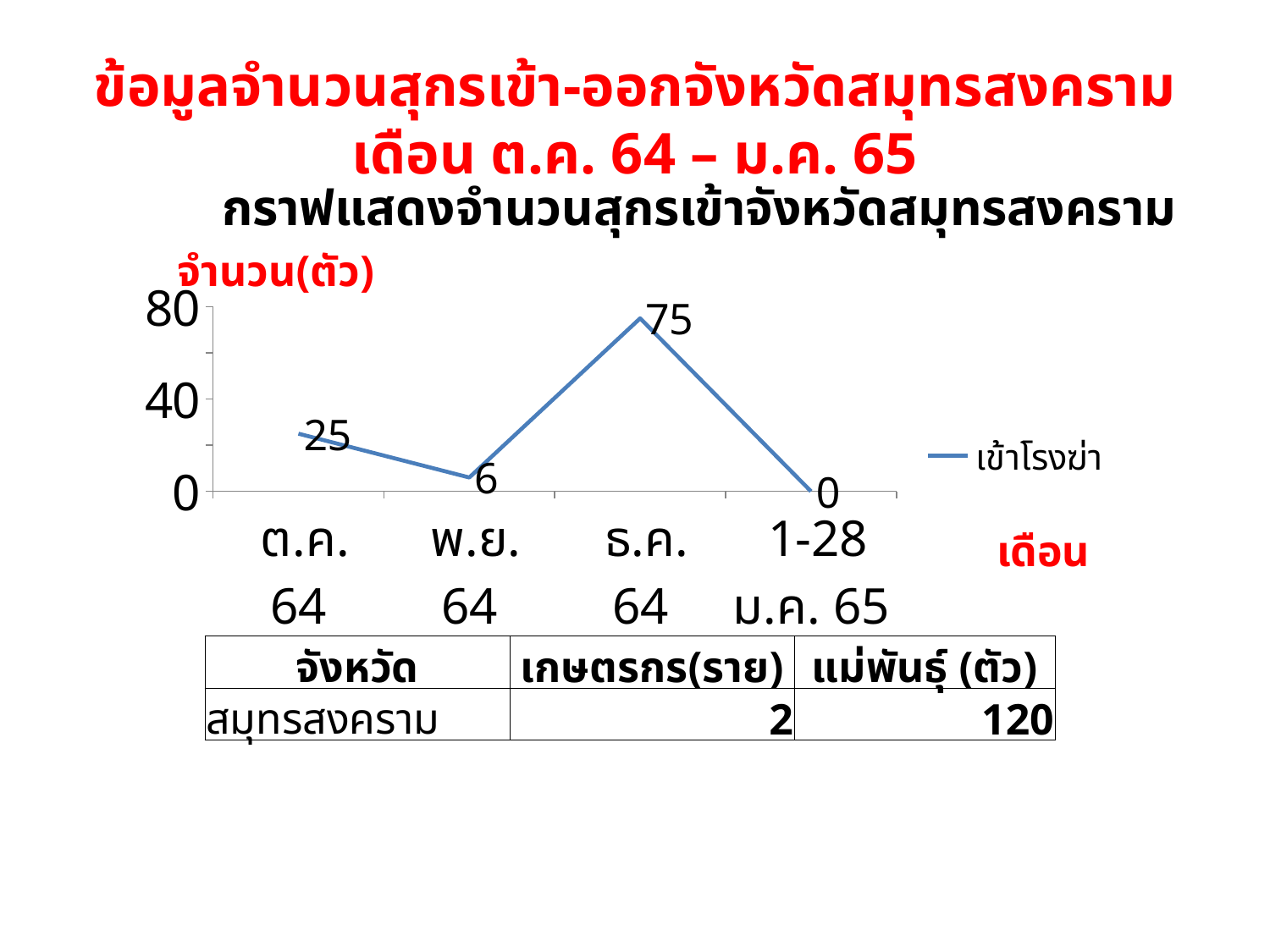
Which month has the lowest value? 1-28 ม.ค. 65 What is the value for 1-28 ม.ค. 65? 0 What is the value for พ.ย. 64? 6 What is the difference between the values for ธ.ค. 64 and ต.ค. 64? 50 What is the name of the series in the legend? เข้าโรงฆ่า Which month has the highest value? ธ.ค. 64 What is the value for ต.ค. 64? 25 What is the value for ธ.ค. 64? 75 How many months are plotted on the x axis? 4 How many series does the legend list? 1 What kind of chart is shown? line chart Which is larger, the value for ต.ค. 64 or the value for พ.ย. 64? ต.ค. 64